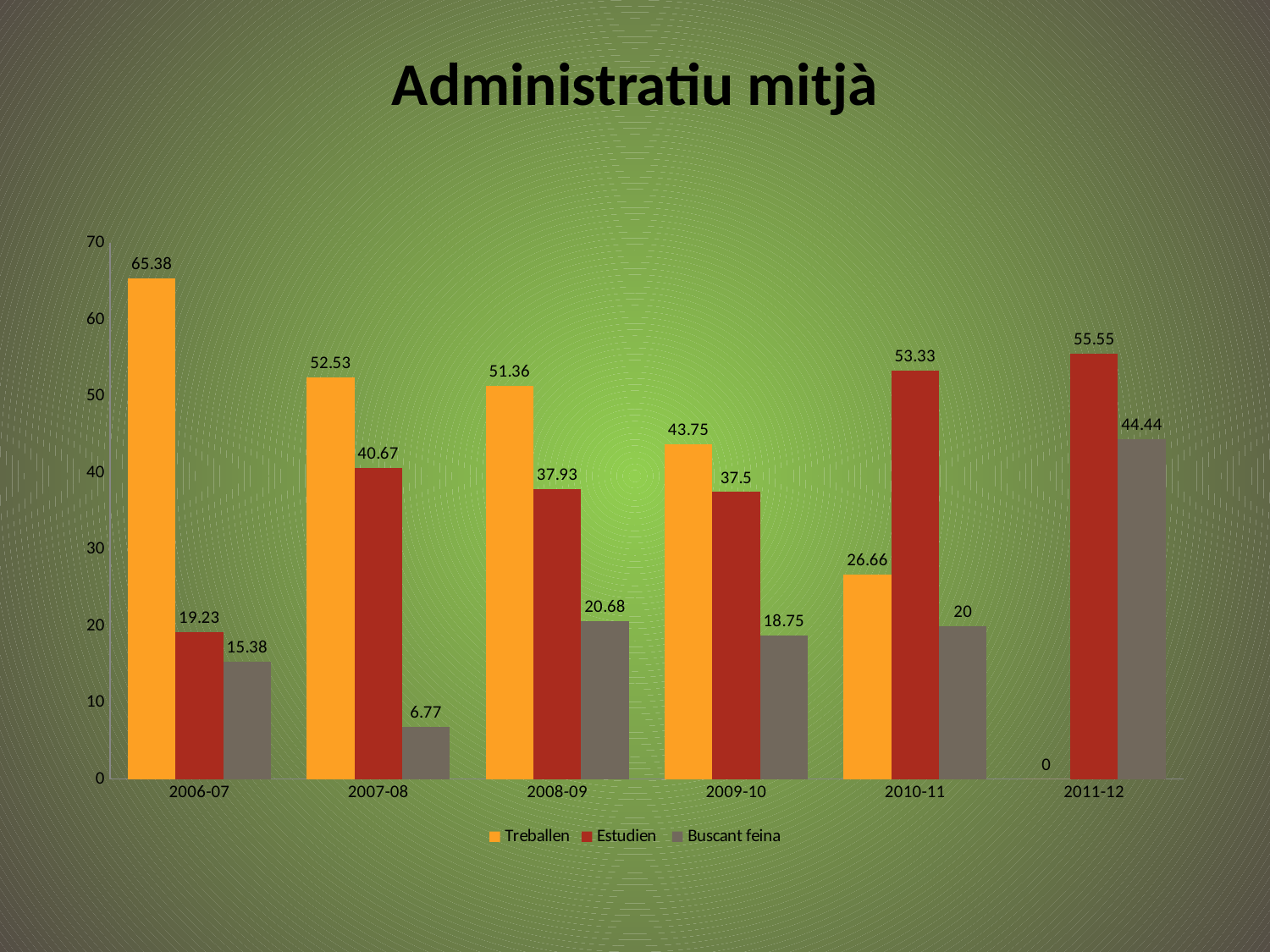
How many years are shown on the x axis? 6 What is the difference between the Estudien values for 2010-11 and 2009-10? 15.83 In which year is the Buscant feina value lowest? 2007-08 What is the value for Estudien in 2011-12? 55.55 What is the value for Buscant feina in 2007-08? 6.77 In which year is the Treballen value highest? 2006-07 Which is larger in 2008-09, Treballen or Estudien? Treballen What kind of chart is shown? bar chart How many series does the legend list? 3 What is the value for Treballen in 2006-07? 65.38 What is the value for Treballen in 2011-12? 0 Does the Treballen value rise or fall from 2006-07 to 2011-12? fall